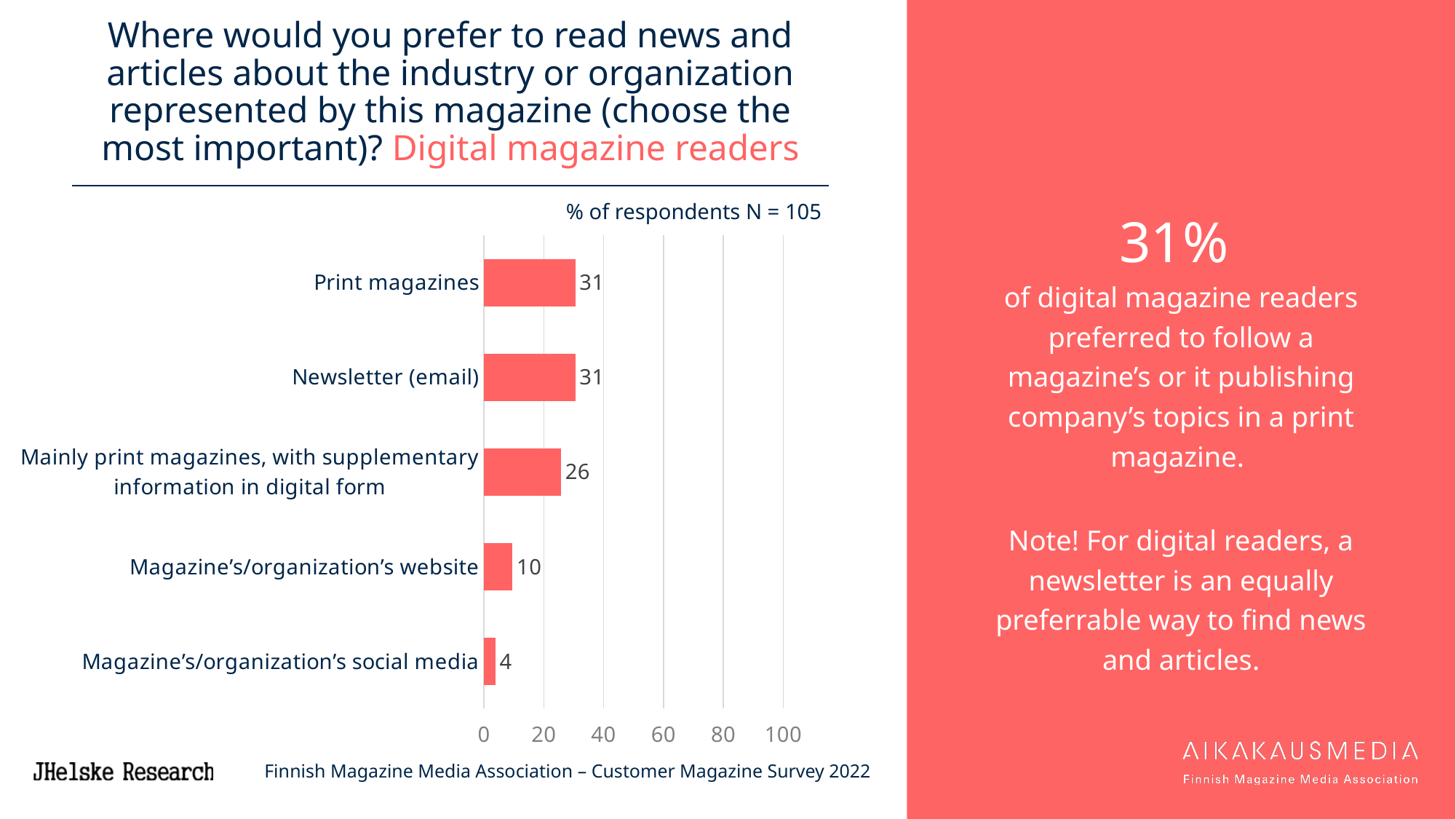
What kind of chart is shown on the slide? Bar chart What is the value for Mainly print magazines, with supplementary information in digital form? 26 What is the value for Newsletter (email)? 31 What is the value for Print magazines? 31 What is the number of respondents (N) stated above the chart? 105 What is the value for Magazine's/organization's website? 10 What is the difference between the values for Newsletter (email) and Magazine's/organization's website? 21 How many categories are shown in the chart? 5 What is the value for Magazine's/organization's social media? 4 Which is larger, the value for Magazine's/organization's website or the value for Magazine's/organization's social media? Magazine's/organization's website Which category has the lowest value? Magazine's/organization's social media What is the difference between the values for Print magazines and Mainly print magazines, with supplementary information in digital form? 5